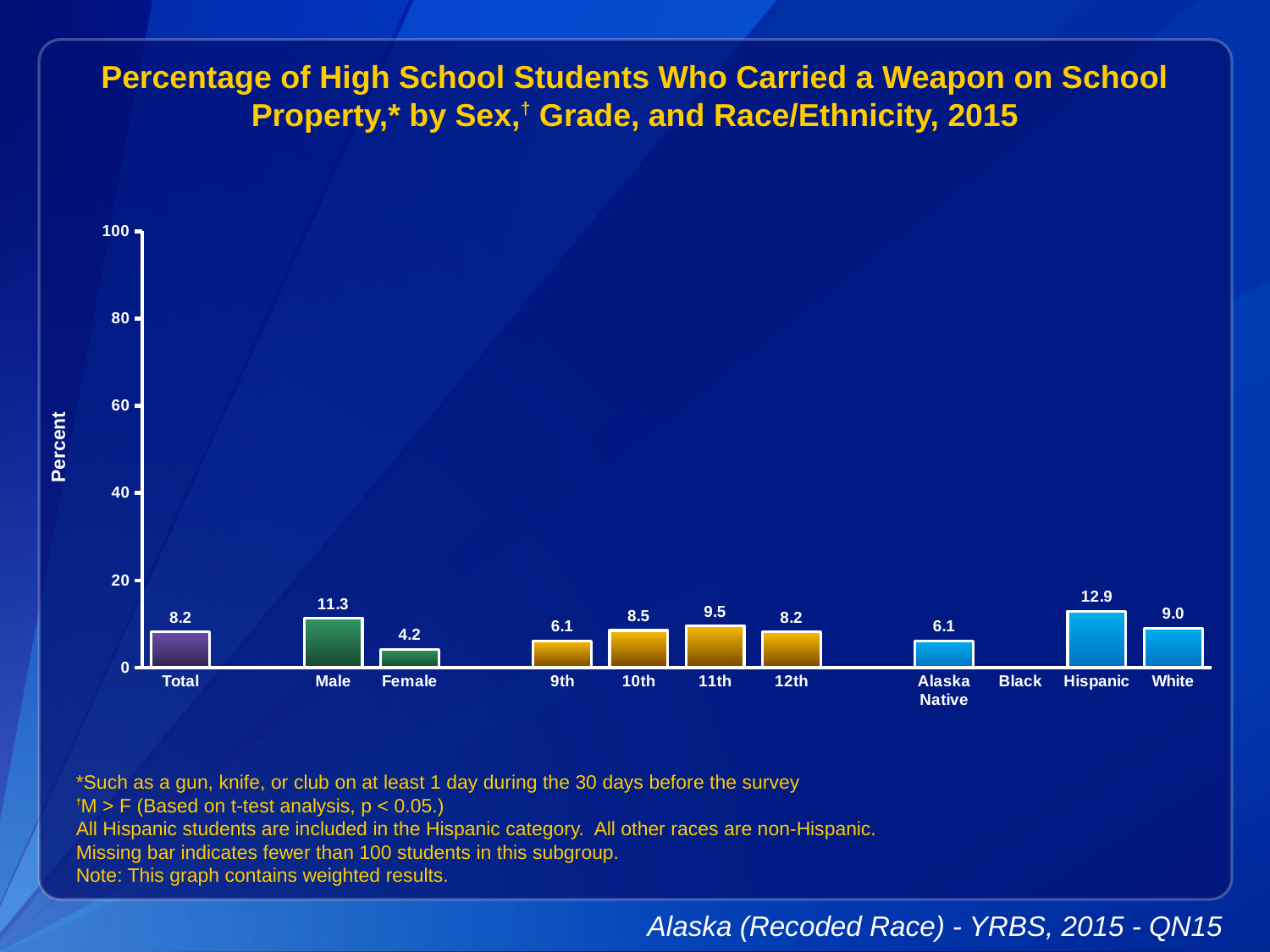
What is the value for Male? 11.3 What kind of chart is shown? bar chart What is the difference between the Male and Female values? 7.1 Is the value for Total greater or less than 20? less Which category has no bar shown? Black What is the value for Hispanic? 12.9 Which is larger, the value for 10th grade or 12th grade? 10th Which category has the highest value? Hispanic What is the value for 11th grade? 9.5 What is the value for Female? 4.2 How many categories are labeled on the x axis? 11 Which category with a plotted bar has the lowest value? Female